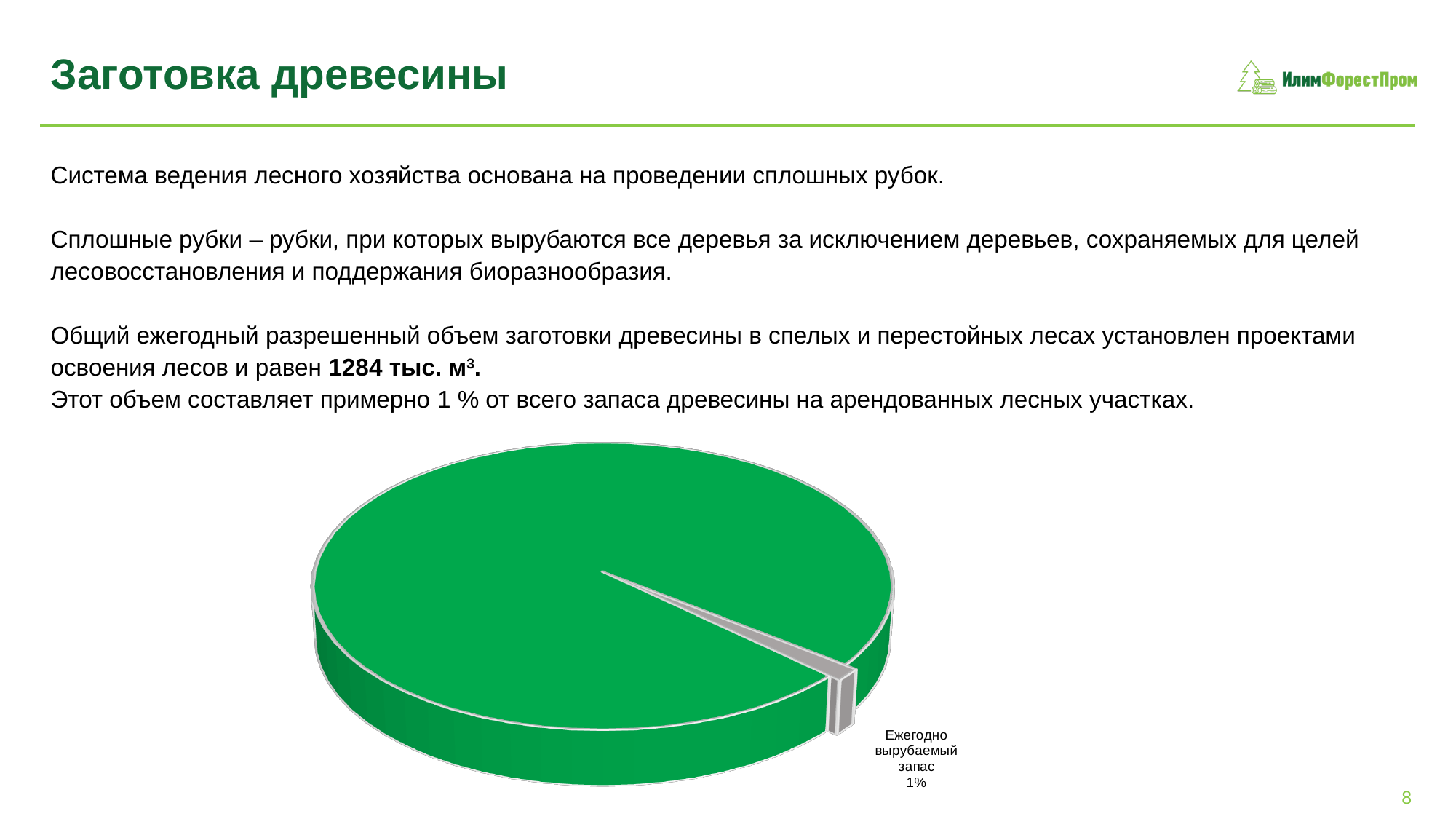
Does the pie chart include a legend? No How many slices does the pie chart have? 2 What share of the pie does the slice labelled "Ежегодно вырубаемый запас" represent? 1% Is the share of "Ежегодно вырубаемый запас" greater or less than 50%? less Which slice is larger in the pie chart: the green slice or the grey slice labelled "Ежегодно вырубаемый запас"? The green slice Is the slice "Ежегодно вырубаемый запас" the largest or the smallest slice of the pie? Smallest What colour is the slice labelled "Ежегодно вырубаемый запас"? Grey What value is printed on the data label of the small slice in the pie chart? 1% What kind of chart is shown on the slide? Pie chart